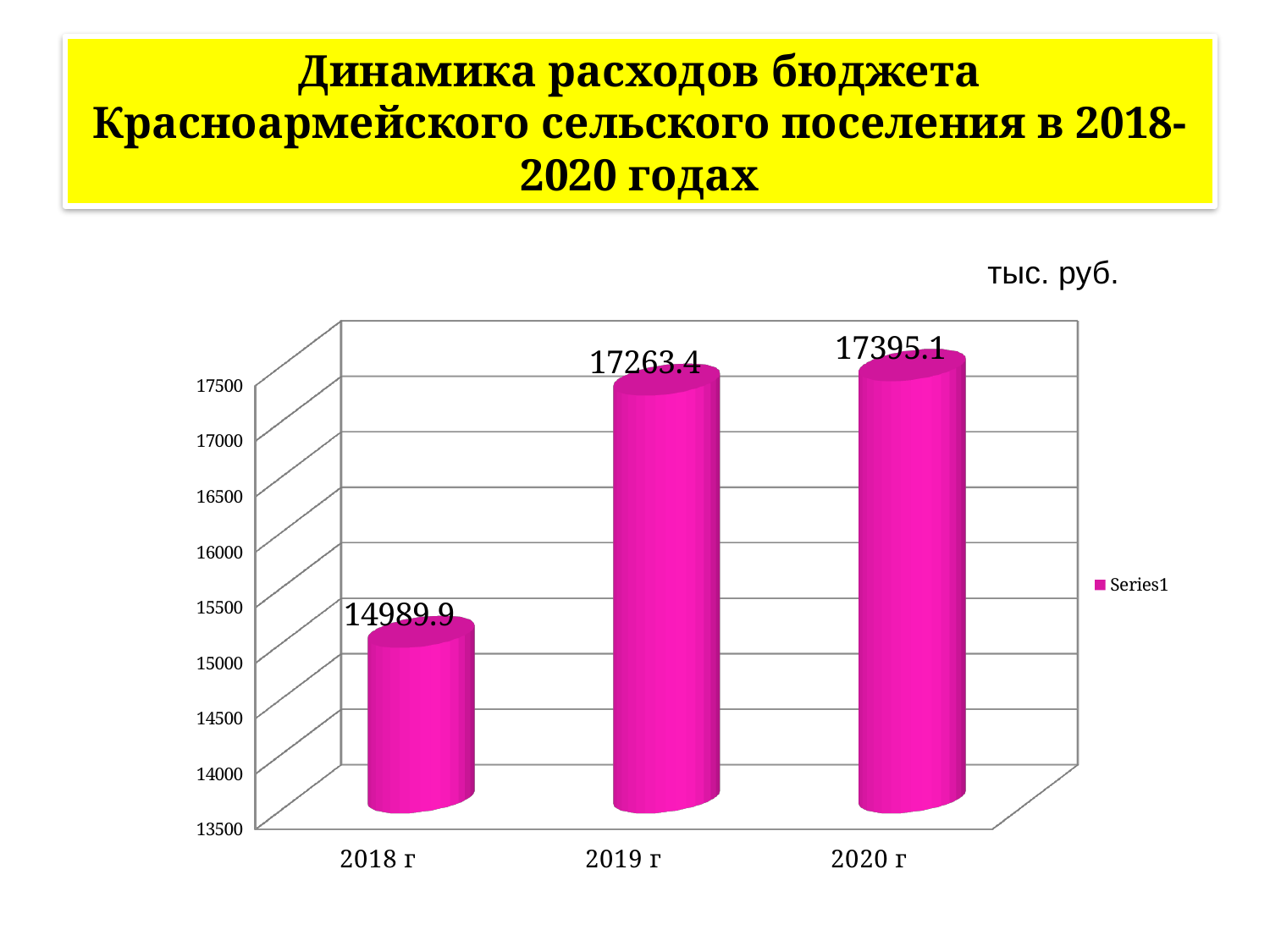
Which is larger, the value for 2018 г or the value for 2019 г? 2019 г What kind of chart is shown on the slide? bar chart Is the value for 2018 г greater or less than 15500? less What is the difference between the values for 2020 г and 2019 г? 131.7 What is the difference between the values for 2019 г and 2018 г? 2273.5 Which year has the lowest value? 2018 г Do the values rise or fall from 2018 г to 2020 г? rise What is the value for 2019 г? 17263.4 Which year has the highest value? 2020 г What is the value for 2020 г? 17395.1 How many categories are shown on the x axis? 3 What is the value for 2018 г? 14989.9